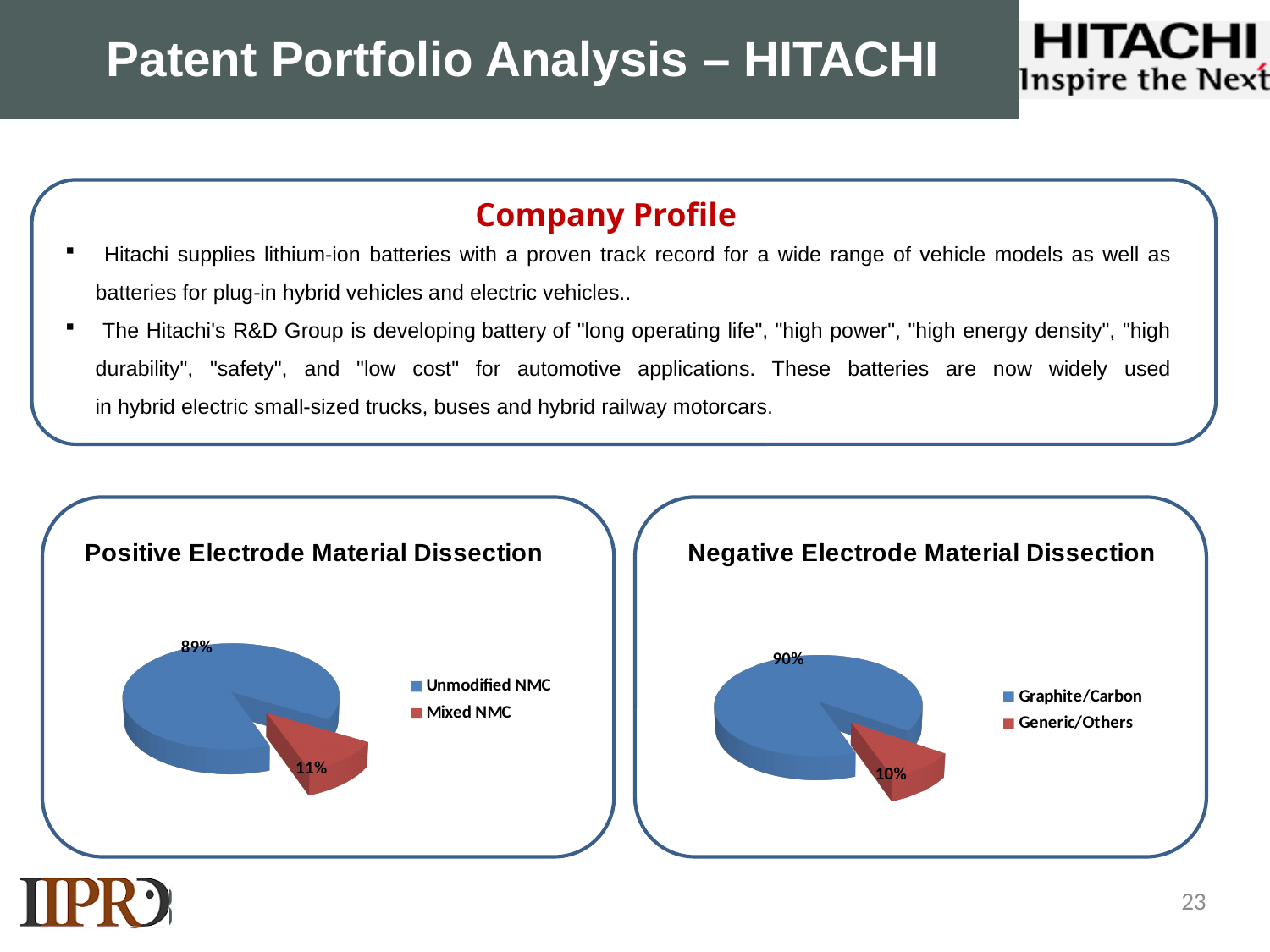
How many categories does the legend of the Positive Electrode Material Dissection chart list? 2 In the Positive Electrode Material Dissection chart, what share does Unmodified NMC have? 89% In the Positive Electrode Material Dissection chart, what is the difference between the Unmodified NMC and Mixed NMC shares? 78% In the Negative Electrode Material Dissection chart, which colour represents Graphite/Carbon? Blue In the Negative Electrode Material Dissection chart, which category has the smallest slice? Generic/Others In the Negative Electrode Material Dissection chart, what share does Generic/Others have? 10% In the Positive Electrode Material Dissection chart, which category has the largest slice? Unmodified NMC In the Positive Electrode Material Dissection chart, what share does Mixed NMC have? 11% In the Positive Electrode Material Dissection chart, is the share for Mixed NMC larger or smaller than the share for Unmodified NMC? Smaller In the Negative Electrode Material Dissection chart, what is the difference between the Graphite/Carbon and Generic/Others shares? 80% In the Negative Electrode Material Dissection chart, what share does Graphite/Carbon have? 90% What type of chart is used in the Negative Electrode Material Dissection panel? Pie chart